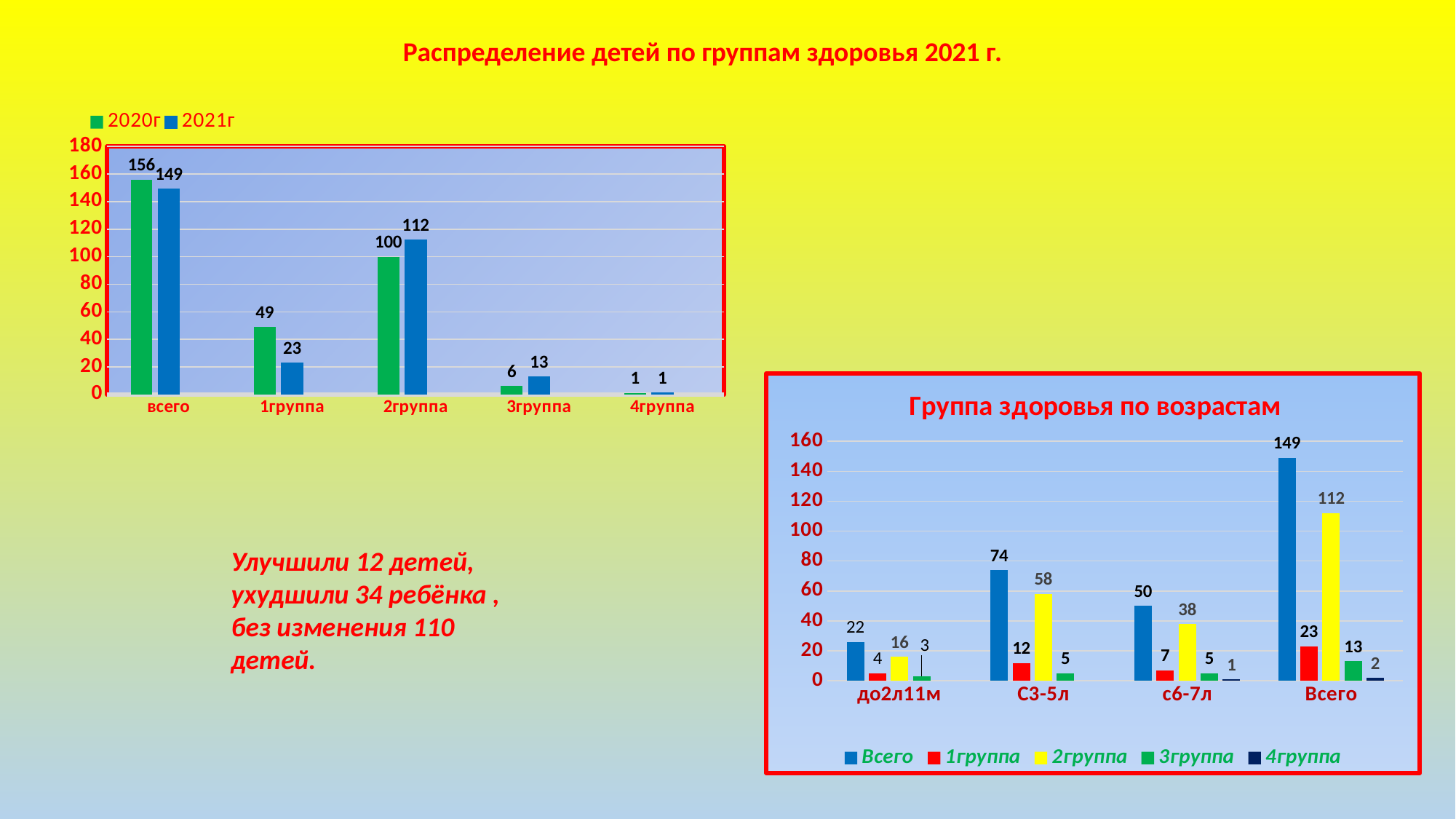
In the chart 'Группа здоровья по возрастам', which age category has the highest Всего value, excluding the Всего category itself? С3-5л In the chart 'Группа здоровья по возрастам', how many series does the legend list? 5 In the chart 'Группа здоровья по возрастам', what is the difference between the Всего and 2группа values for the Всего category? 37 In the top-left chart, what is the value for 2группа in 2021г? 112 In the top-left chart, how many series does the legend list? 2 In the chart 'Группа здоровья по возрастам', what is the value of Всего for с6-7л? 50 In the chart 'Группа здоровья по возрастам', what is the value of 2группа for С3-5л? 58 What kind of chart is the chart titled 'Группа здоровья по возрастам'? bar chart In the top-left chart, how many categories are shown on the x axis? 5 In the top-left chart, which is larger for 3группа: the 2020г value or the 2021г value? 2021г In the top-left chart, what is the value for 1группа in 2020г? 49 In the top-left chart, what is the difference between the 2020г and 2021г values for всего? 7